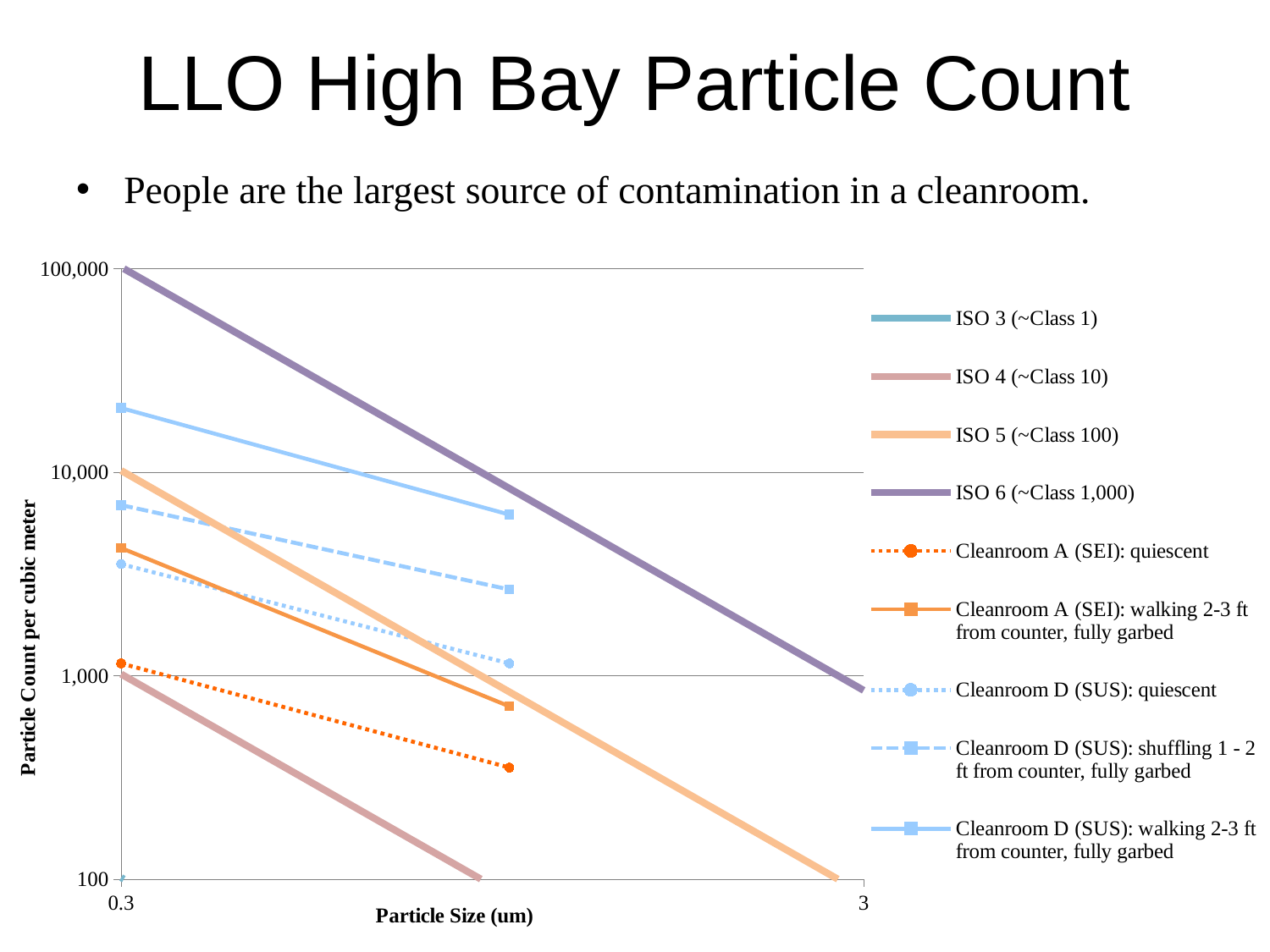
What kind of chart is shown on the slide? Line chart Is the value for Cleanroom D (SUS): shuffling 1 - 2 ft from counter, fully garbed at 0.3 um greater or less than 10,000? less Which series has the highest particle count at a particle size of 0.3 um? ISO 6 (~Class 1,000) At 0.3 um, which is larger: Cleanroom D (SUS): walking 2-3 ft from counter, fully garbed or Cleanroom A (SEI): walking 2-3 ft from counter, fully garbed? Cleanroom D (SUS): walking 2-3 ft from counter, fully garbed What is the label of the y axis? Particle Count per cubic meter How many series does the chart legend list? 9 Do the particle counts rise or fall as particle size increases along the x axis? fall Is the value for Cleanroom D (SUS): walking 2-3 ft from counter, fully garbed at 0.3 um greater or less than 10,000? greater Is the right-hand end value of Cleanroom A (SEI): quiescent greater or less than 1,000? less